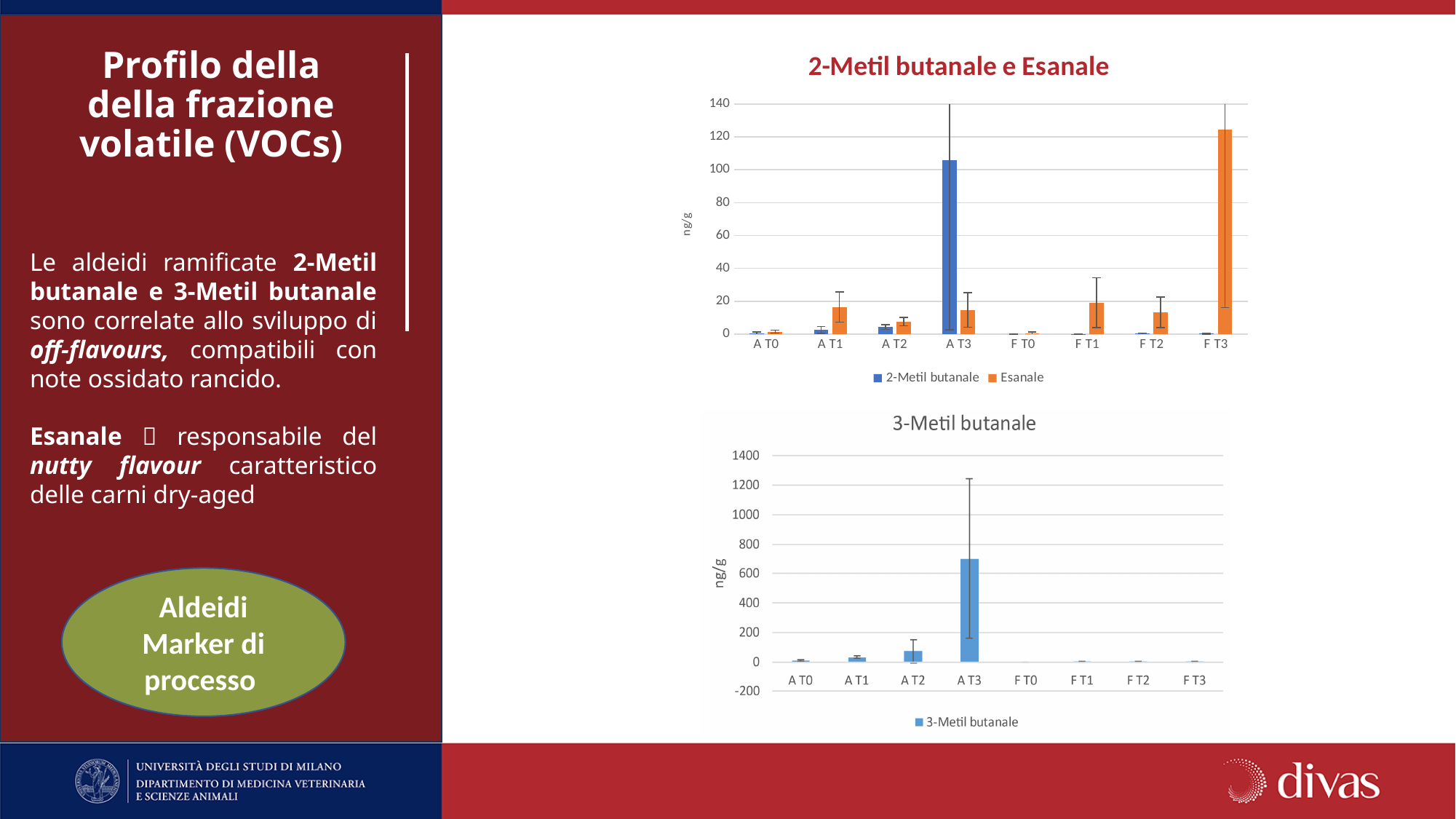
What is the y-axis unit label on the bottom chart '3-Metil butanale'? ng/g In the top chart '2-Metil butanale e Esanale', is the value of 2-Metil butanale for A T3 greater or less than 100? greater In the top chart '2-Metil butanale e Esanale', how many series does the legend list? 2 In the top chart '2-Metil butanale e Esanale', which category has the highest value for Esanale? F T3 In the top chart '2-Metil butanale e Esanale', which category has the highest value for 2-Metil butanale? A T3 In the top chart '2-Metil butanale e Esanale', is the value of Esanale for F T3 greater or less than 100? greater In the bottom chart '3-Metil butanale', is the value for A T3 greater or less than 600? greater In the top chart '2-Metil butanale e Esanale', at A T3, which series has the larger value, 2-Metil butanale or Esanale? 2-Metil butanale In the top chart '2-Metil butanale e Esanale', at F T3, which series has the larger value, 2-Metil butanale or Esanale? Esanale What kind of chart is the top chart titled '2-Metil butanale e Esanale'? bar chart In the bottom chart '3-Metil butanale', which category has the highest value? A T3 In the top chart '2-Metil butanale e Esanale', how many categories are shown on the x axis? 8